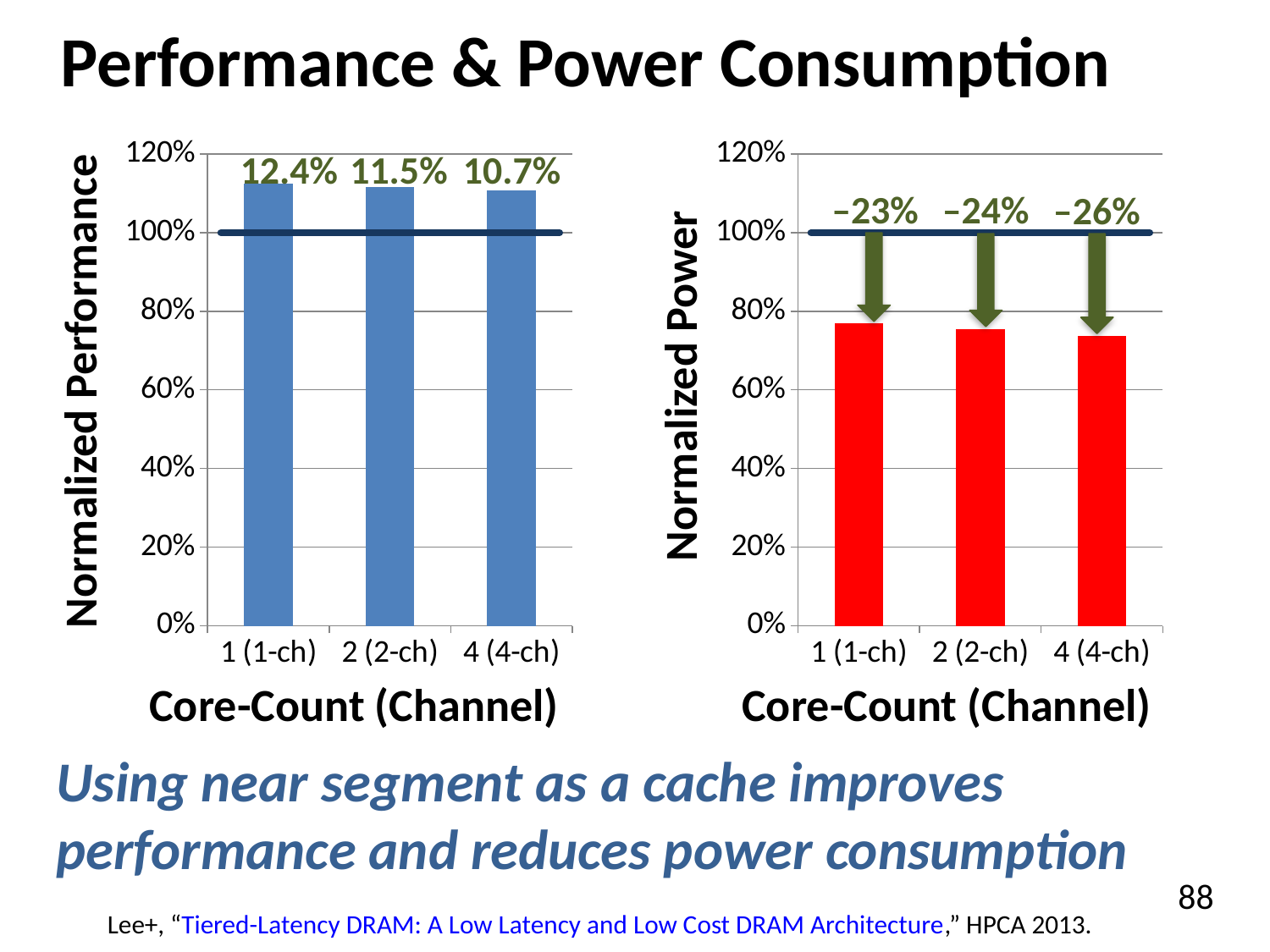
On the right chart (Normalized Power), what reduction label is printed above the 2 (2-ch) bar? –24% On the left chart (Normalized Performance), what improvement label is printed above the 1 (1-ch) bar? 12.4% On the right chart (Normalized Power), do the bar values rise or fall as the core count increases from 1 (1-ch) to 4 (4-ch)? fall On the right chart (Normalized Power), what reduction label is printed above the 4 (4-ch) bar? –26% How many core-count categories are shown on the left chart (Normalized Performance)? 3 On the left chart (Normalized Performance), what improvement label is printed above the 4 (4-ch) bar? 10.7% What is the x-axis title of the right chart (Normalized Power)? Core-Count (Channel) On the left chart (Normalized Performance), which category has the largest labeled performance improvement? 1 (1-ch) What kind of chart is the right chart (Normalized Power)? bar chart On the right chart (Normalized Power), is the bar for 1 (1-ch) greater or less than 80%? less On the left chart (Normalized Performance), is the bar for 2 (2-ch) greater or less than 100%? greater On the right chart (Normalized Power), is the bar for 4 (4-ch) greater or less than 60%? greater